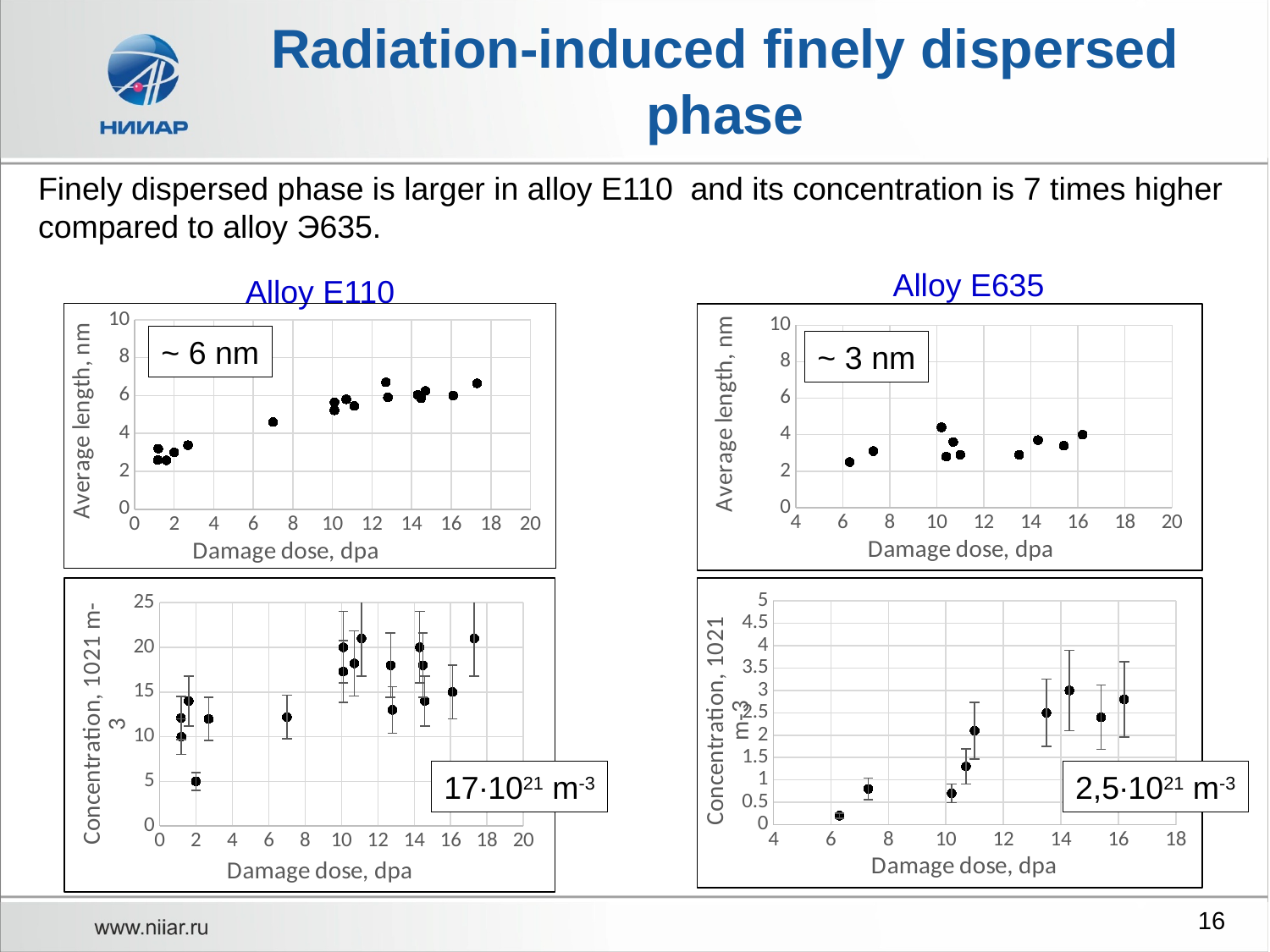
What kind of chart is the Alloy E110 average length chart (top left)? scatter chart In the Alloy E110 concentration chart (bottom left), is the value at the highest damage dose (about 17 dpa) greater or less than 15? greater In the Alloy E110 average length chart (top left), which is larger: the value at about 1 dpa or the value at about 17 dpa? the value at about 17 dpa What value is written in the annotation box on the Alloy E110 average length chart (top left)? ~ 6 nm What value is written in the annotation box on the Alloy E635 concentration chart (bottom right)? 2,5·10^21 m^-3 In the Alloy E110 concentration chart (bottom left), is the lowest plotted value (at about 2 dpa) greater or less than 10? less In the Alloy E110 average length chart (top left), do the values rise or fall as damage dose increases? rise In the Alloy E110 average length chart (top left), is the value at the highest damage dose (about 17 dpa) greater or less than 4? greater How many charts are shown on the slide? 4 In the Alloy E635 concentration chart (bottom right), do the values rise or fall as damage dose increases? rise